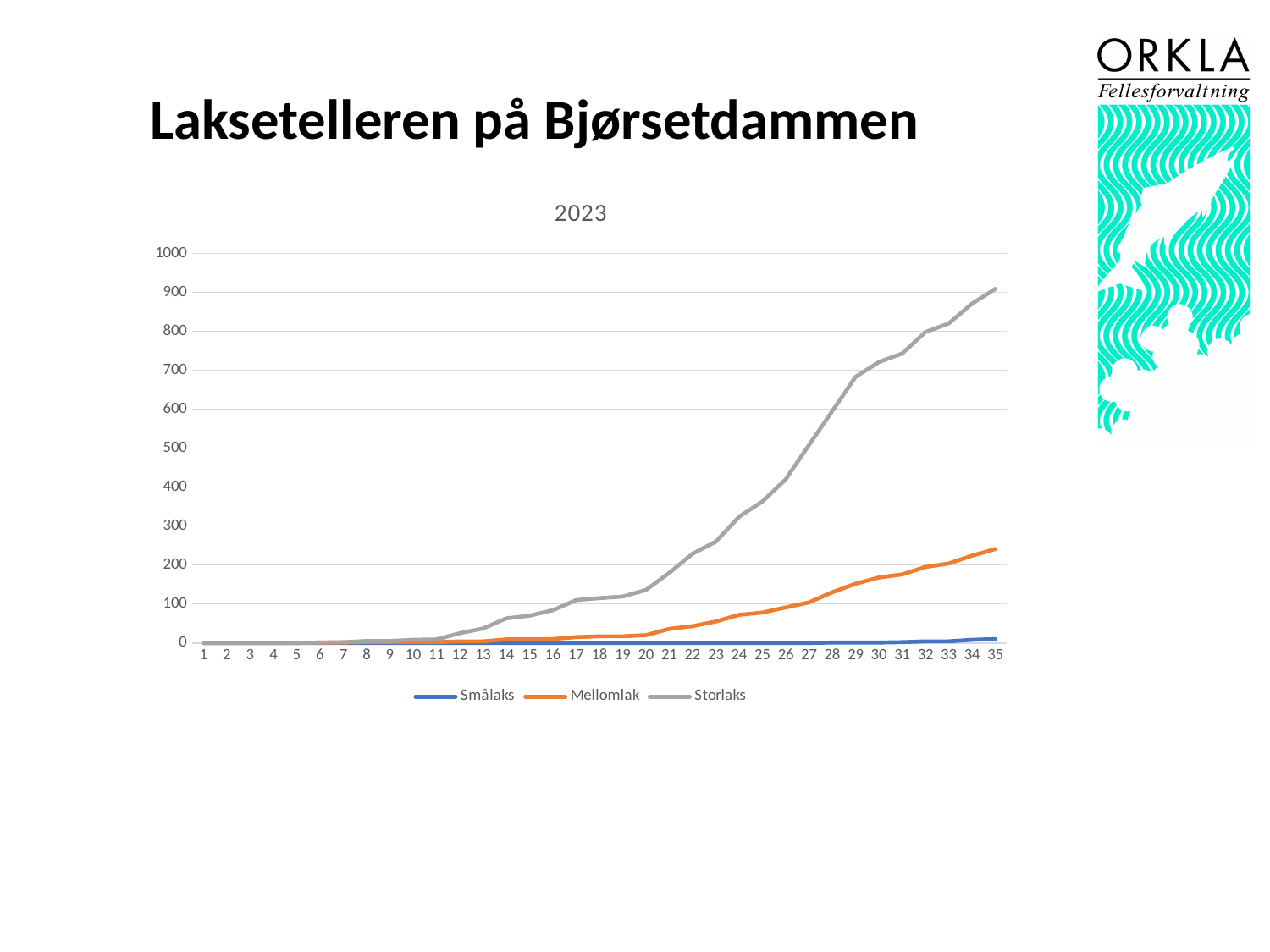
Which series has the highest value at point 35? Storlaks Is the value for Storlaks at point 20 greater or less than 200? less Which series are listed in the legend? Smålaks, Mellomlak, Storlaks How many series does the legend list? 3 How many points are marked along the x axis? 35 Is the value for Mellomlak at point 35 greater or less than 300? less Which series has the lowest value at point 35? Smålaks What is the title of the chart? 2023 At point 30, which is larger: Mellomlak or Smålaks? Mellomlak Does the Storlaks line rise or fall along the x axis? rises What kind of chart is shown on the slide? line chart